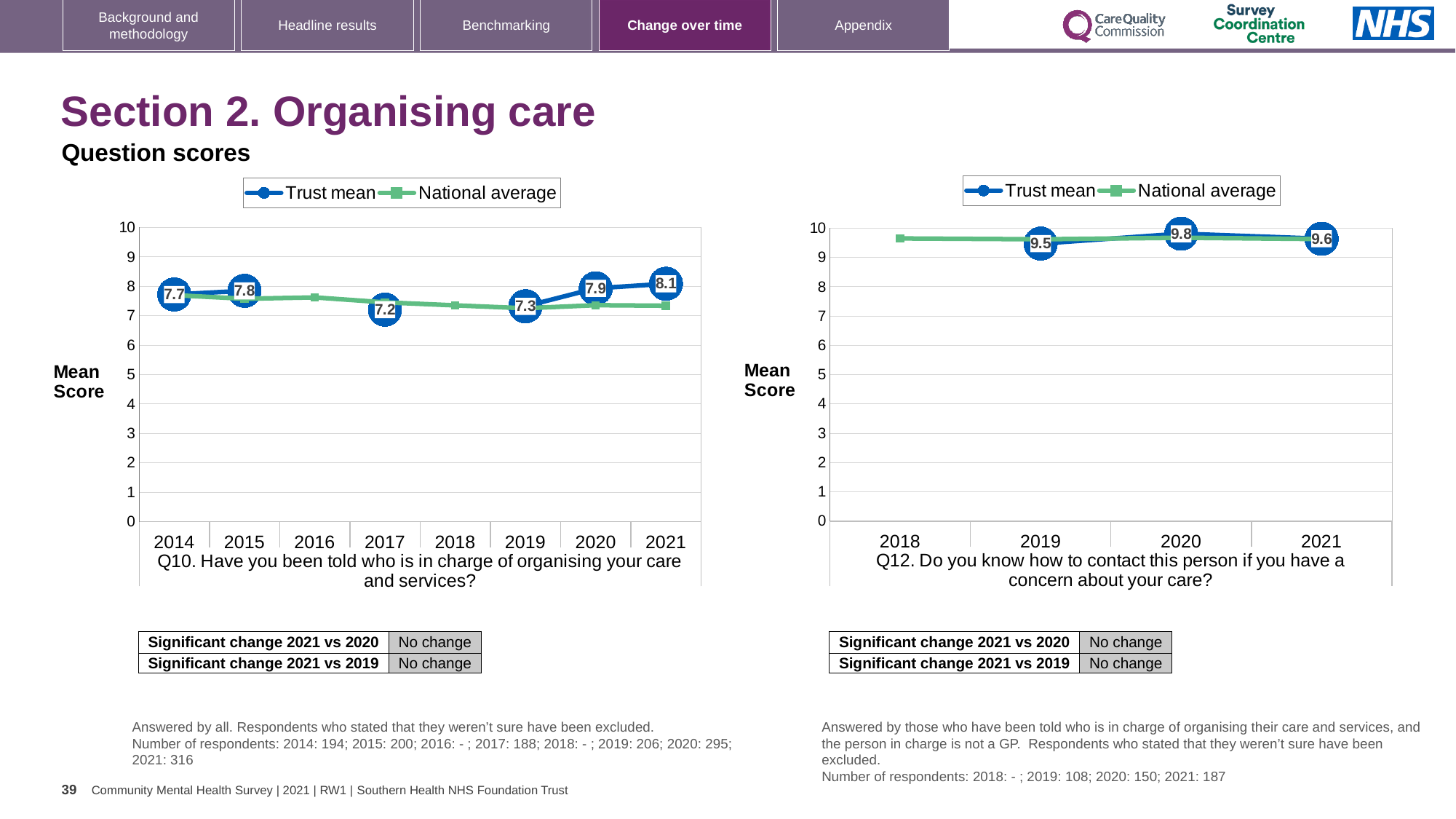
In the Q12 chart on the right, what is the Trust mean for 2020? 9.8 In the Q10 chart on the left, what is the Trust mean for 2021? 8.1 In the Q10 chart on the left, which year has the lowest labelled Trust mean? 2017 In the Q12 chart on the right, which year has the highest Trust mean? 2020 In the Q10 chart on the left, is the Trust mean for 2014 greater or less than the Trust mean for 2015? less In the Q10 chart on the left, how many years are shown on the x axis? 8 How many series does the legend of the Q12 chart on the right list? 2 In the Q10 chart on the left, which year has the highest Trust mean? 2021 In the Q12 chart on the right, is the National average for 2018 greater or less than 9? greater In the Q10 chart on the left, what is the difference between the Trust mean in 2021 and in 2020? 0.2 In the Q10 chart on the left, what is the Trust mean for 2017? 7.2 In the Q12 chart on the right, what is the difference between the Trust mean in 2020 and in 2019? 0.3